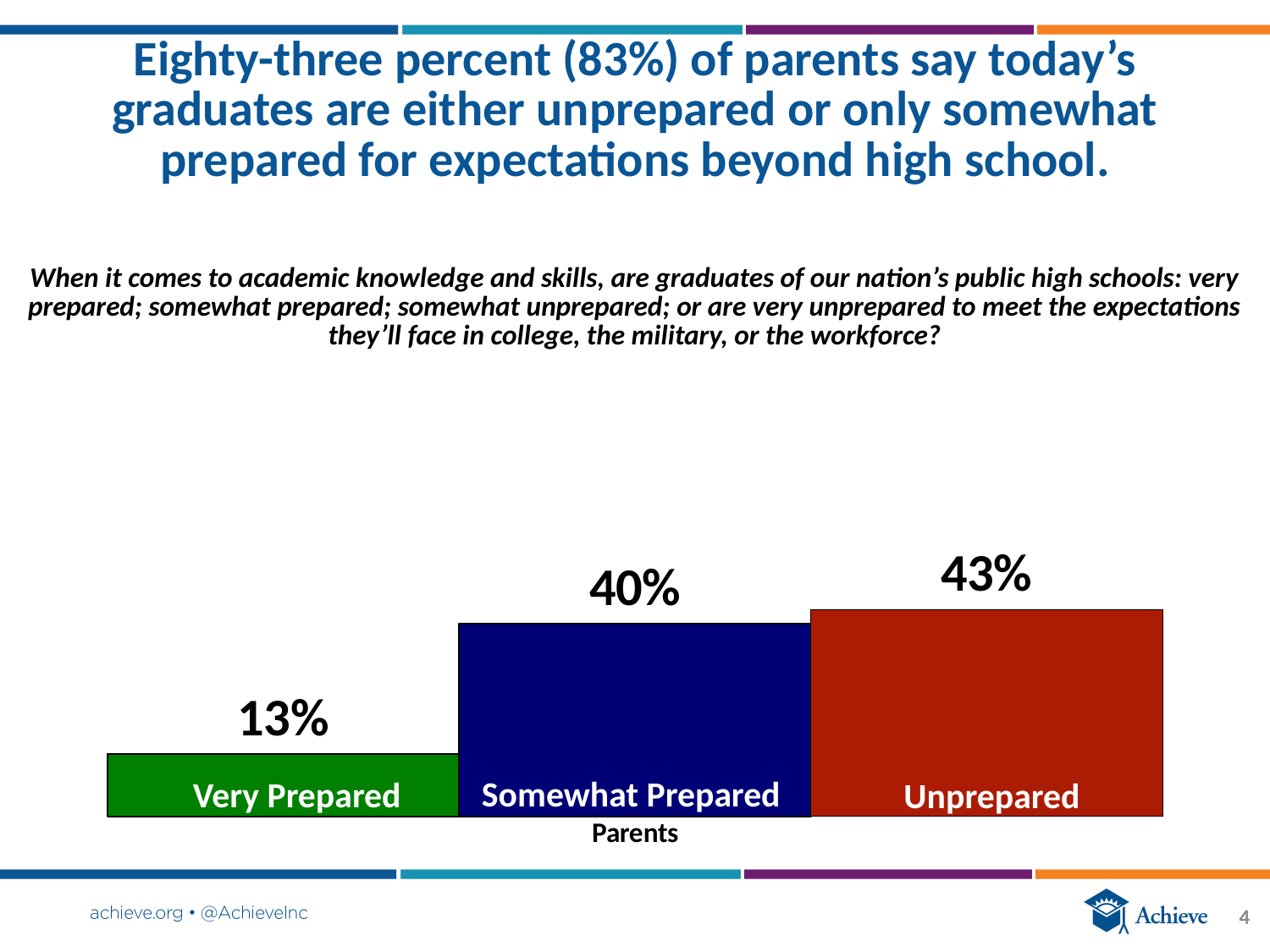
What kind of chart is shown on the slide? Bar chart Do the values rise or fall from left to right across the categories? Rise Which is larger, the value for Somewhat Prepared or the value for Very Prepared? Somewhat Prepared What percentage of parents say graduates are Very Prepared? 13% Which category has the lowest value in the chart? Very Prepared What is the difference between the Unprepared and Very Prepared values? 30% How many categories are shown in the chart? 3 What percentage of parents say graduates are Somewhat Prepared? 40% What is the difference between the Somewhat Prepared and Very Prepared values? 27% What is the label shown beneath the bars on the x axis? Parents Which category has the highest value in the chart? Unprepared What percentage of parents say graduates are Unprepared? 43%